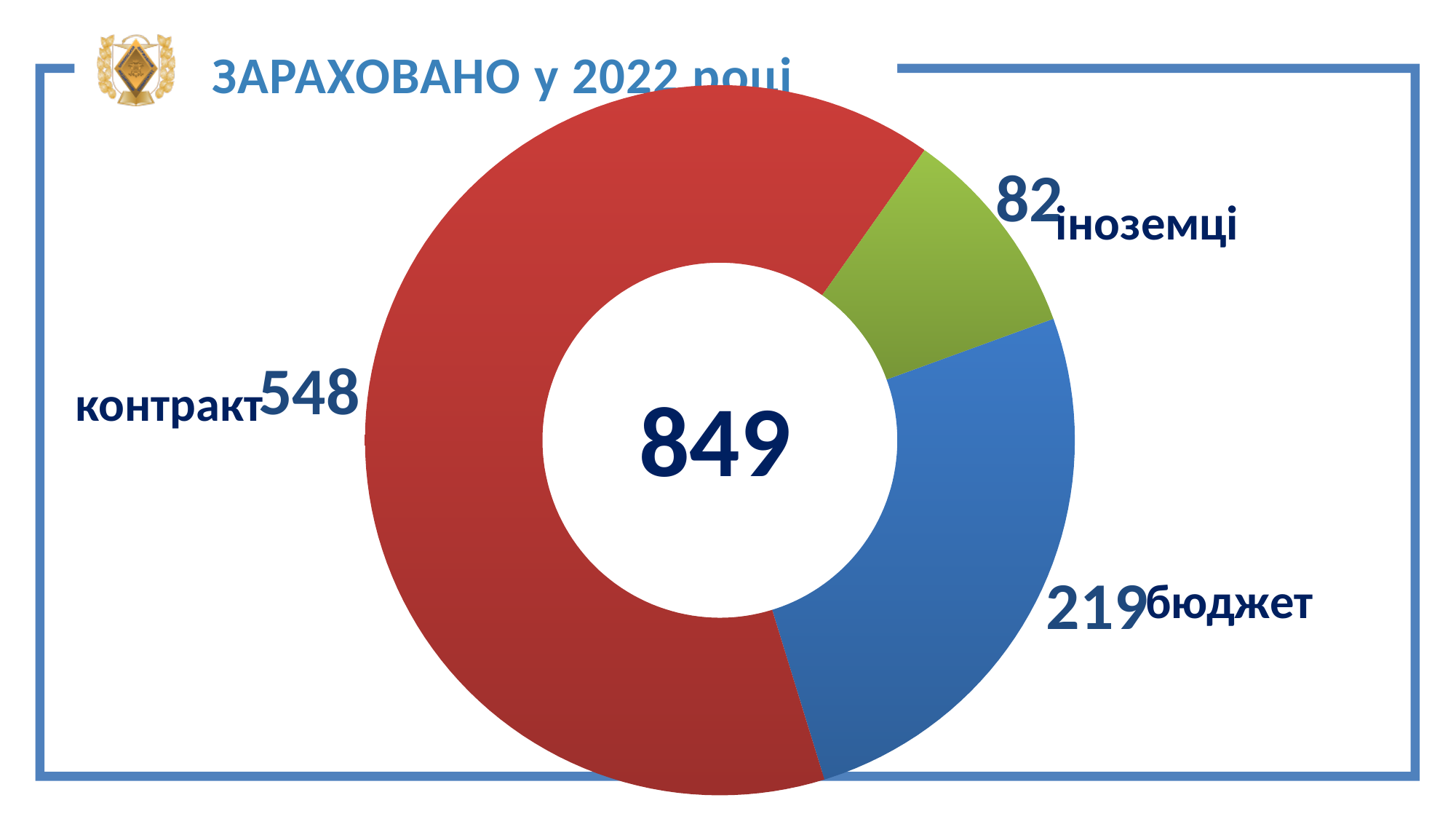
How many categories does the chart show? 3 What is the value for бюджет? 219 What is the difference between the values for бюджет and іноземці? 137 Which category has the lowest value? іноземці What is the value for контракт? 548 What is the title of the slide? ЗАРАХОВАНО у 2022 році What kind of chart is shown on the slide? doughnut chart What total is shown in the centre of the chart? 849 Which category has the highest value? контракт What is the difference between the values for контракт and бюджет? 329 What is the value for іноземці? 82 Which is larger, the value for бюджет or the value for іноземці? бюджет